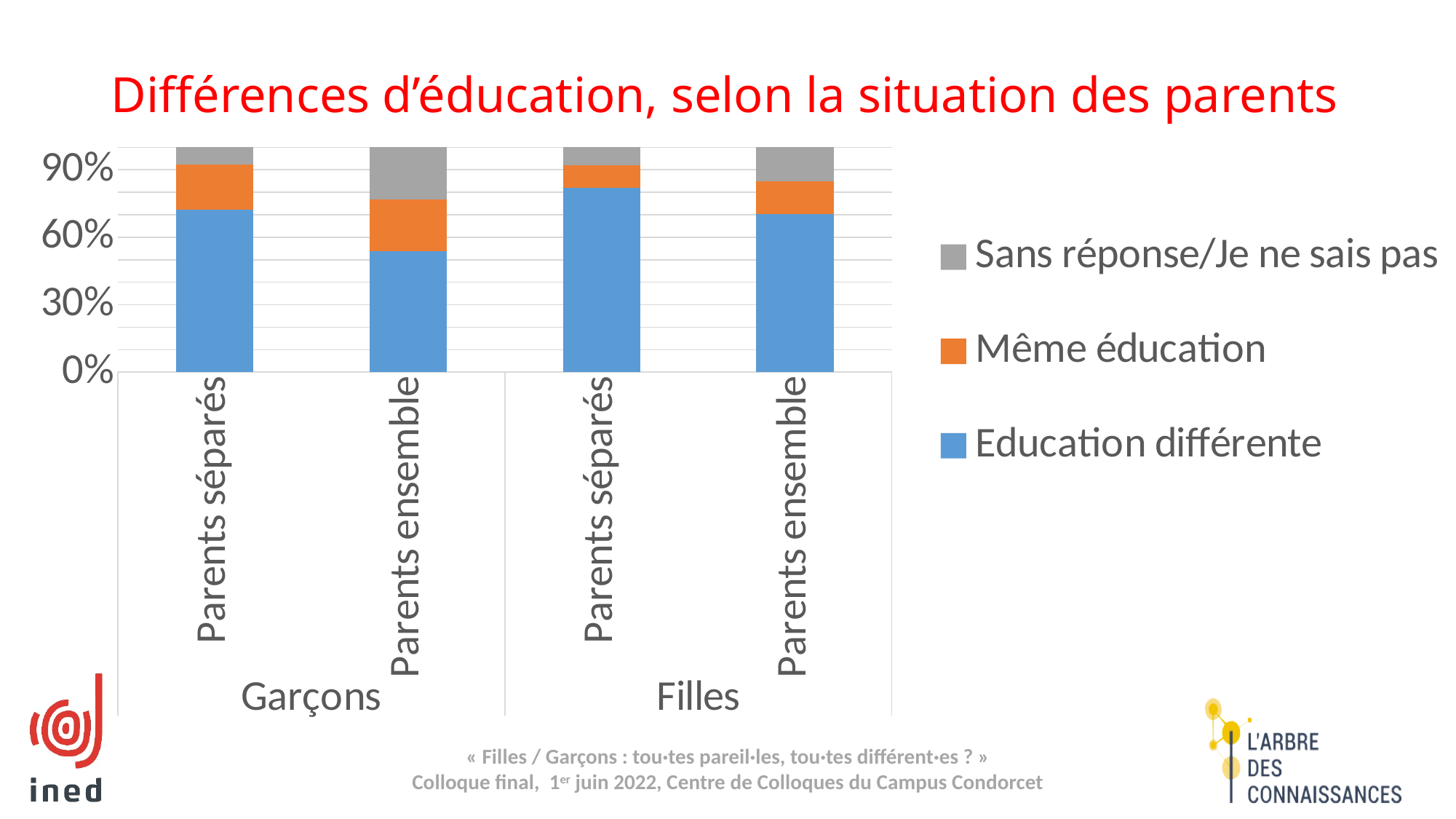
What is the title of the chart? Différences d'éducation, selon la situation des parents Which bar has the largest 'Education différente' share? Filles, Parents séparés Among Garçons, which has the larger 'Education différente' share: Parents séparés or Parents ensemble? Parents séparés Is the 'Education différente' value for Garçons, Parents séparés greater or less than 60%? greater How many bars are plotted in the chart? 4 What kind of chart is shown on the slide? Stacked bar chart Which bar has the smallest 'Education différente' share? Garçons, Parents ensemble Is the 'Education différente' value for Filles, Parents séparés greater or less than 60%? greater Which colour represents 'Même éducation' in the legend? Orange How many series does the legend list? 3 Is the 'Education différente' value for Garçons, Parents ensemble greater or less than 60%? less Which bar has the largest 'Sans réponse/Je ne sais pas' segment? Garçons, Parents ensemble